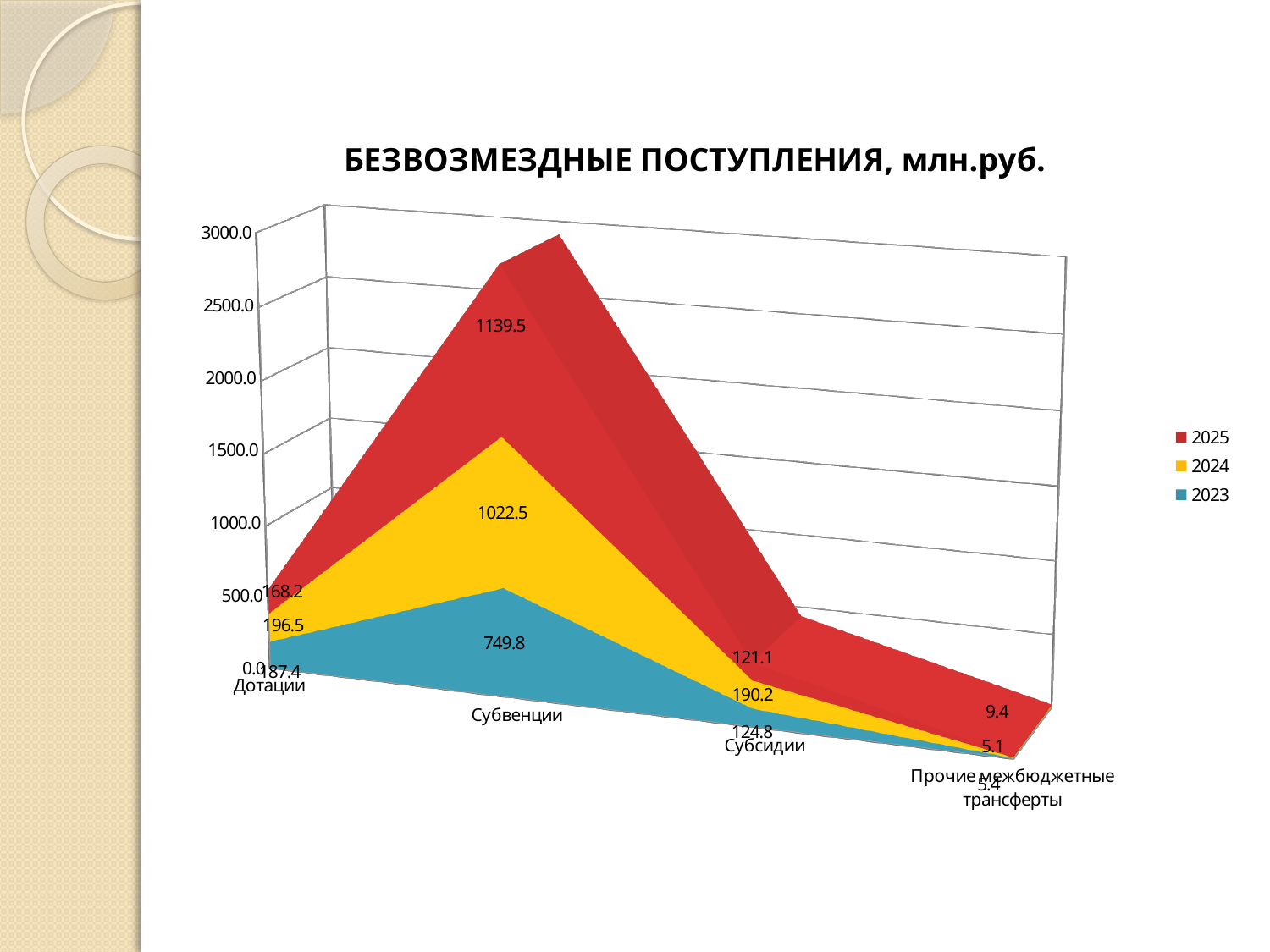
What is the value for Прочие межбюджетные трансферты in the 2025 series? 9.4 What is the title of the chart? БЕЗВОЗМЕЗДНЫЕ ПОСТУПЛЕНИЯ, млн.руб. What is the value for Субвенции in the 2025 series? 1139.5 What is the difference between the 2025 and 2024 values for Субвенции? 117.0 Which category has the lowest value in the 2024 series? Прочие межбюджетные трансферты How many categories are shown along the x axis? 4 How many series does the legend list? 3 What kind of chart is shown on the slide? Area chart Which category has the highest value in the 2025 series? Субвенции What is the value for Субсидии in the 2024 series? 190.2 For Субсидии, which is larger: the 2024 value or the 2023 value? 2024 What is the value for Субвенции in the 2023 series? 749.8